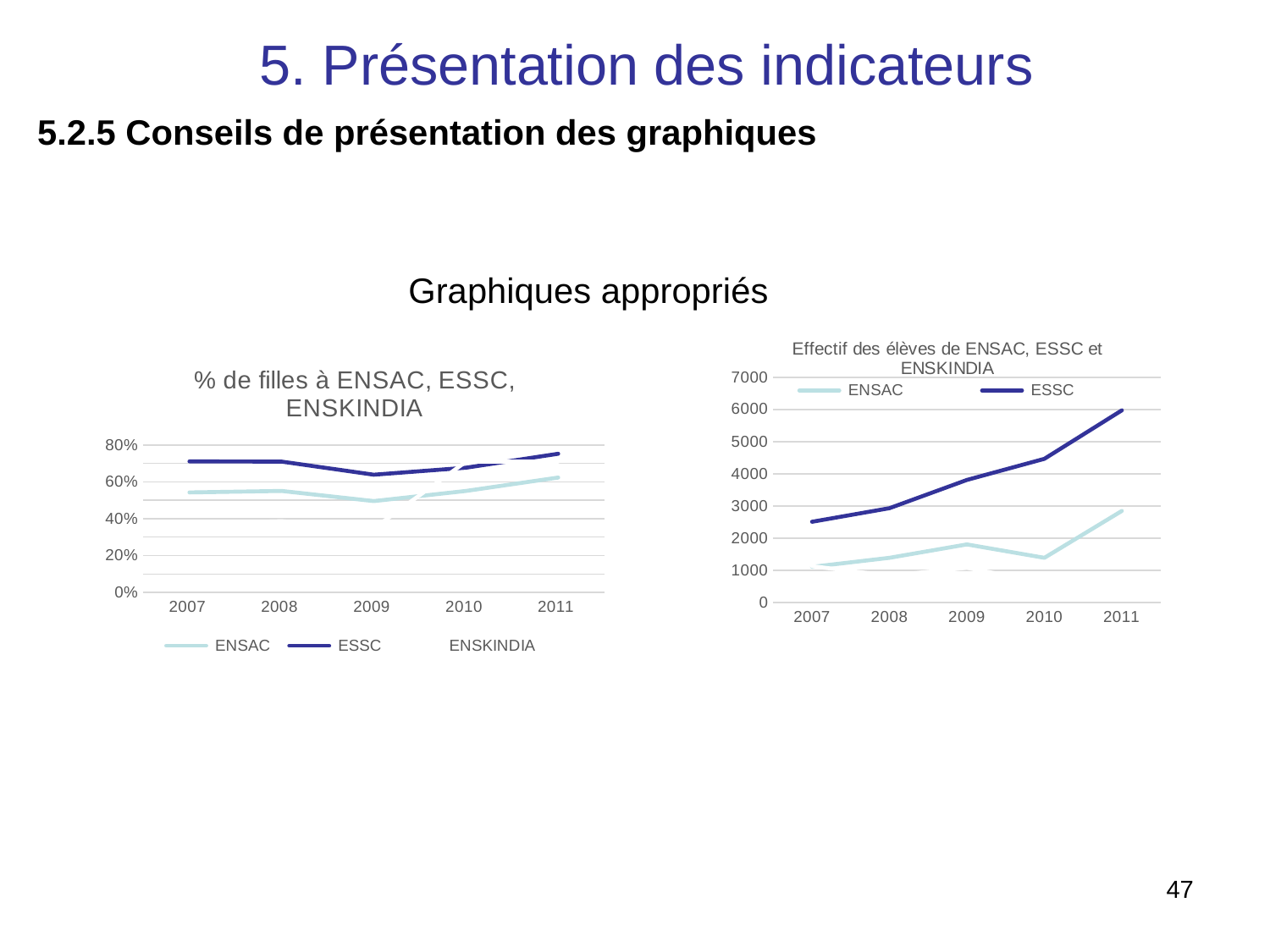
In the right chart 'Effectif des élèves de ENSAC, ESSC et ENSKINDIA', in which year is the ESSC value highest? 2011 In the left chart '% de filles à ENSAC, ESSC, ENSKINDIA', how many series does the legend list? 3 What kind of chart is the right chart titled 'Effectif des élèves de ENSAC, ESSC et ENSKINDIA'? line chart In the right chart 'Effectif des élèves de ENSAC, ESSC et ENSKINDIA', is the value for ESSC in 2011 greater or less than 5000? greater In the left chart '% de filles à ENSAC, ESSC, ENSKINDIA', which series has the higher value in 2011, ENSAC or ESSC? ESSC In the right chart 'Effectif des élèves de ENSAC, ESSC et ENSKINDIA', does the ESSC line rise or fall from 2007 to 2011? rise In the left chart '% de filles à ENSAC, ESSC, ENSKINDIA', is the value for ENSAC in 2009 greater or less than 60%? less In the left chart '% de filles à ENSAC, ESSC, ENSKINDIA', how many years are shown on the x axis? 5 What kind of chart is the left chart titled '% de filles à ENSAC, ESSC, ENSKINDIA'? line chart In the left chart '% de filles à ENSAC, ESSC, ENSKINDIA', is the value for ESSC in 2007 greater or less than 60%? greater In the right chart 'Effectif des élèves de ENSAC, ESSC et ENSKINDIA', which series has the higher value in 2011, ENSAC or ESSC? ESSC